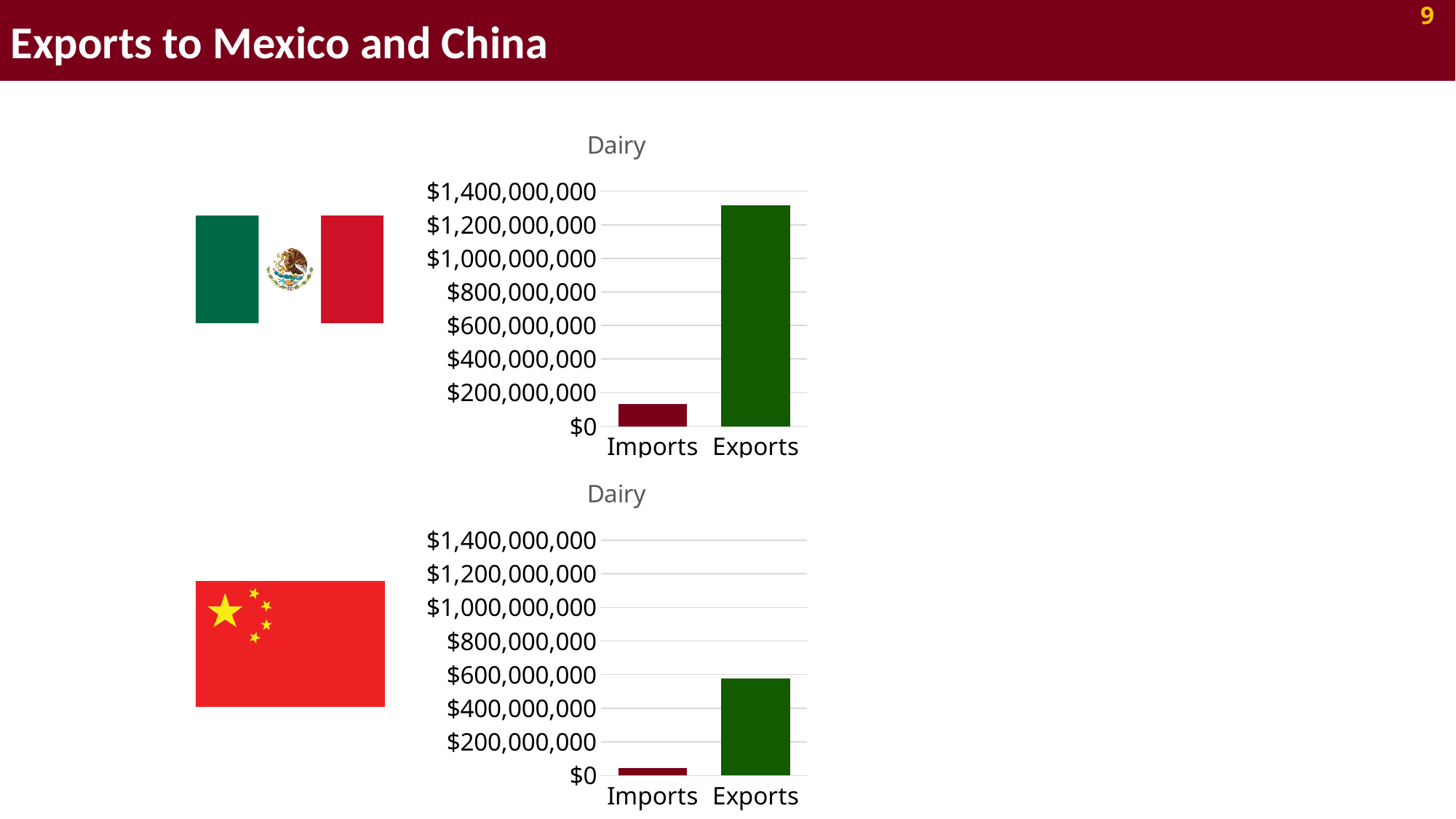
In the top chart (next to the Mexican flag), which category has the lower value? Imports In the bottom chart (next to the Chinese flag), is the value for Imports greater or less than $200,000,000? less In the bottom chart (next to the Chinese flag), is the value for Exports greater or less than $400,000,000? greater What kind of chart is the bottom chart (next to the Chinese flag)? Bar chart In the top chart (next to the Mexican flag), which category has the higher value, Imports or Exports? Exports In the bottom chart (next to the Chinese flag), is the value for Exports greater or less than $800,000,000? less How many categories are shown on the x axis of the top chart (next to the Mexican flag)? 2 What is the highest value shown on the y axis of the bottom chart (next to the Chinese flag)? $1,400,000,000 What is the title of the top chart (next to the Mexican flag)? Dairy In the bottom chart (next to the Chinese flag), which category has the higher value, Imports or Exports? Exports